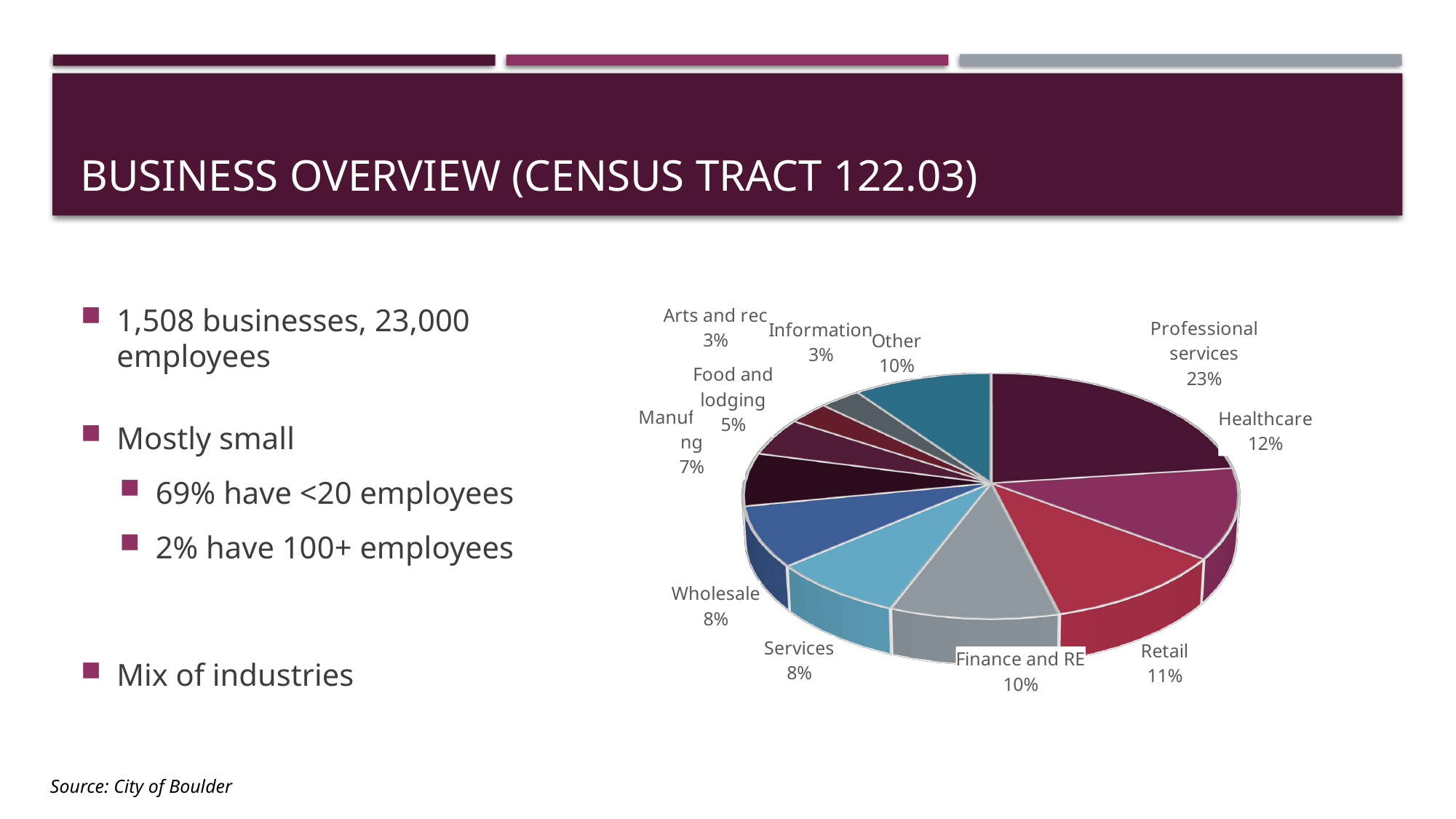
What is the combined share of Arts and rec and Information? 6% What kind of chart is shown on the slide? Pie chart What share of the pie does Professional services hold? 23% What is the value shown for the Other slice? 10% Which category has the largest slice of the pie? Professional services What is the value shown for Healthcare? 12% What percentage is shown for Food and lodging? 5% What percentage is shown for Retail? 11% What is the difference between the Professional services share and the Healthcare share? 11% How many slices does the pie chart have? 11 What is the value for Finance and RE? 10% Which is larger, the Retail slice or the Wholesale slice? Retail